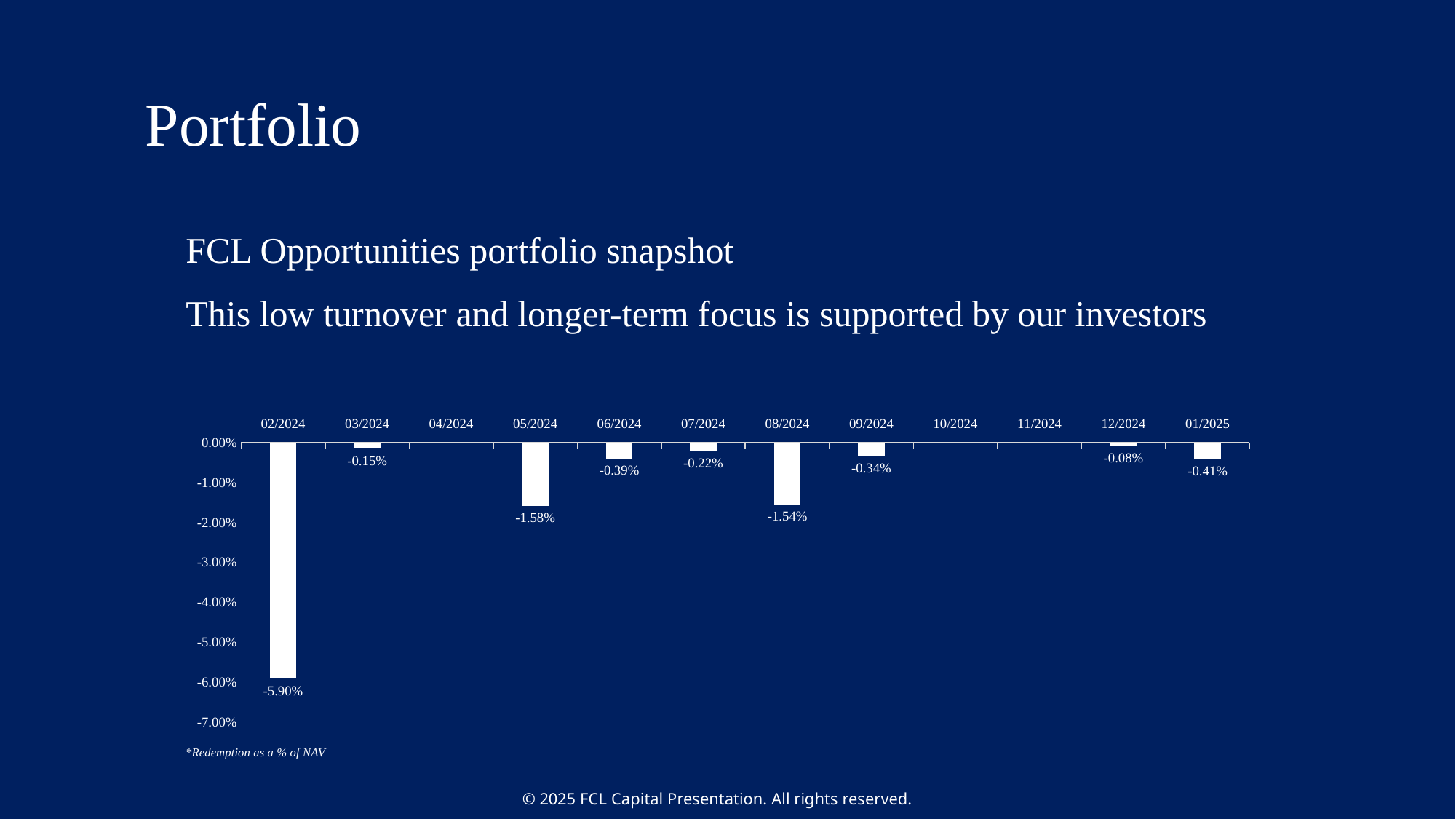
Is the value for 02/2024 greater or less than -5.00%? less What is the difference between the values for 02/2024 and 05/2024? 4.32 percentage points What is the value shown for 12/2024? -0.08% Which month has the lowest (most negative) value on the chart? 02/2024 What is the value shown for 02/2024? -5.90% What is the difference between the values for 05/2024 and 08/2024? 0.04 percentage points What is the value shown for 08/2024? -1.54% What kind of chart is shown on the slide? Bar chart Which month shows a larger redemption as a % of NAV, 06/2024 or 07/2024? 06/2024 What is the value shown for 01/2025? -0.41% What is the value shown for 05/2024? -1.58% How many months are shown on the x axis of the chart? 12